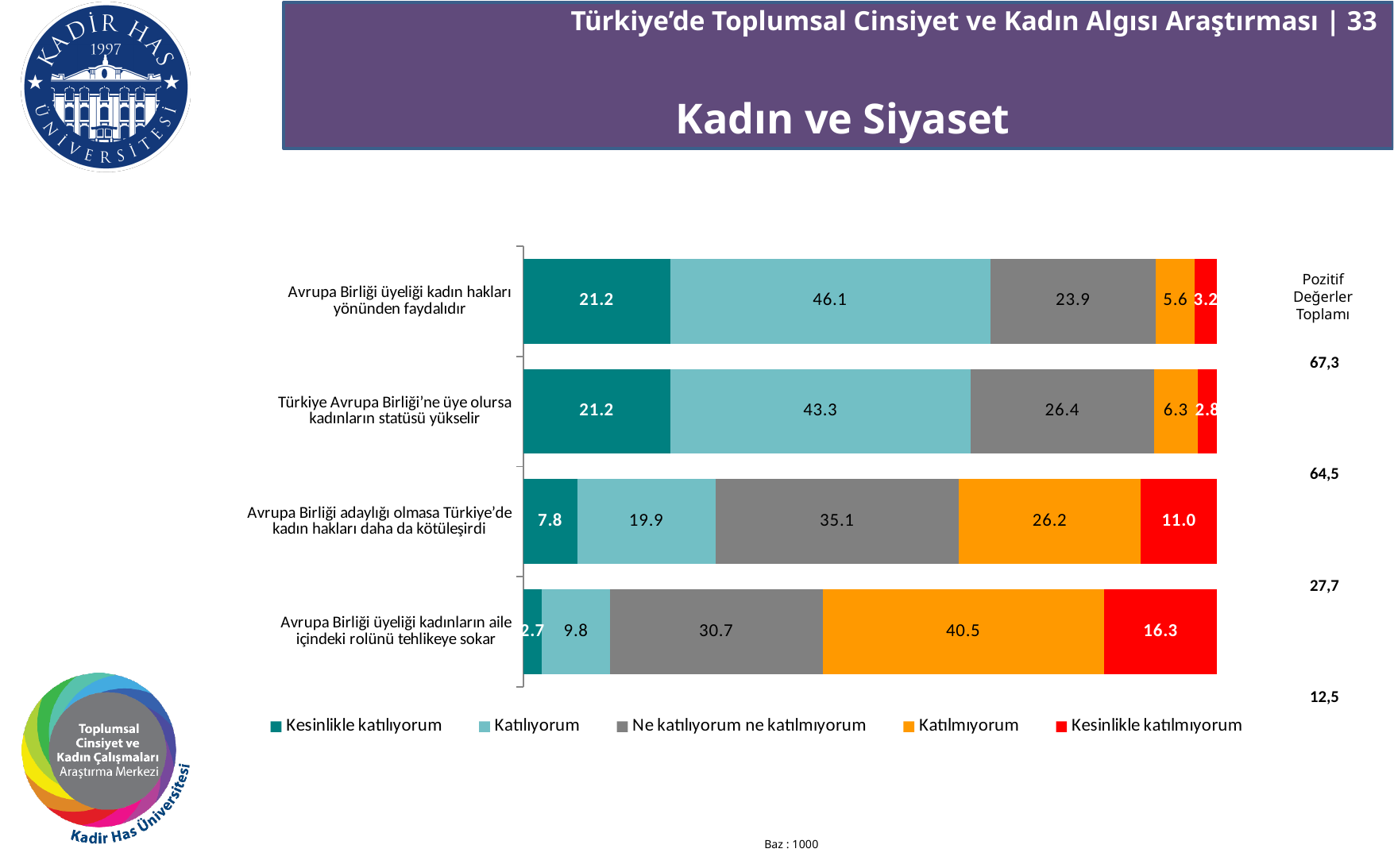
Which statement has the lowest 'Kesinlikle katılıyorum' value? Avrupa Birliği üyeliği kadınların aile içindeki rolünü tehlikeye sokar What is the 'Pozitif Değerler Toplamı' shown for 'Türkiye Avrupa Birliği'ne üye olursa kadınların statüsü yükselir'? 64,5 What is the 'Kesinlikle katılmıyorum' value for 'Avrupa Birliği üyeliği kadınların aile içindeki rolünü tehlikeye sokar'? 16.3 What is the total of the stacked bar for 'Avrupa Birliği üyeliği kadınların aile içindeki rolünü tehlikeye sokar'? 100.0 Which is larger: the 'Katılmıyorum' value for 'Avrupa Birliği adaylığı olmasa Türkiye'de kadın hakları daha da kötüleşirdi' or for 'Türkiye Avrupa Birliği'ne üye olursa kadınların statüsü yükselir'? Avrupa Birliği adaylığı olmasa Türkiye'de kadın hakları daha da kötüleşirdi What is the 'Ne katılıyorum ne katılmıyorum' value for 'Avrupa Birliği adaylığı olmasa Türkiye'de kadın hakları daha da kötüleşirdi'? 35.1 What is the 'Katılıyorum' value for 'Avrupa Birliği üyeliği kadın hakları yönünden faydalıdır'? 46.1 How many series does the legend list? 5 What kind of chart is shown on the slide? Stacked bar chart Which statement has the highest 'Katılmıyorum' value? Avrupa Birliği üyeliği kadınların aile içindeki rolünü tehlikeye sokar What is the difference between the 'Katılıyorum' values for 'Avrupa Birliği üyeliği kadın hakları yönünden faydalıdır' and 'Türkiye Avrupa Birliği'ne üye olursa kadınların statüsü yükselir'? 2.8 How many statements (categories) are plotted in the chart? 4